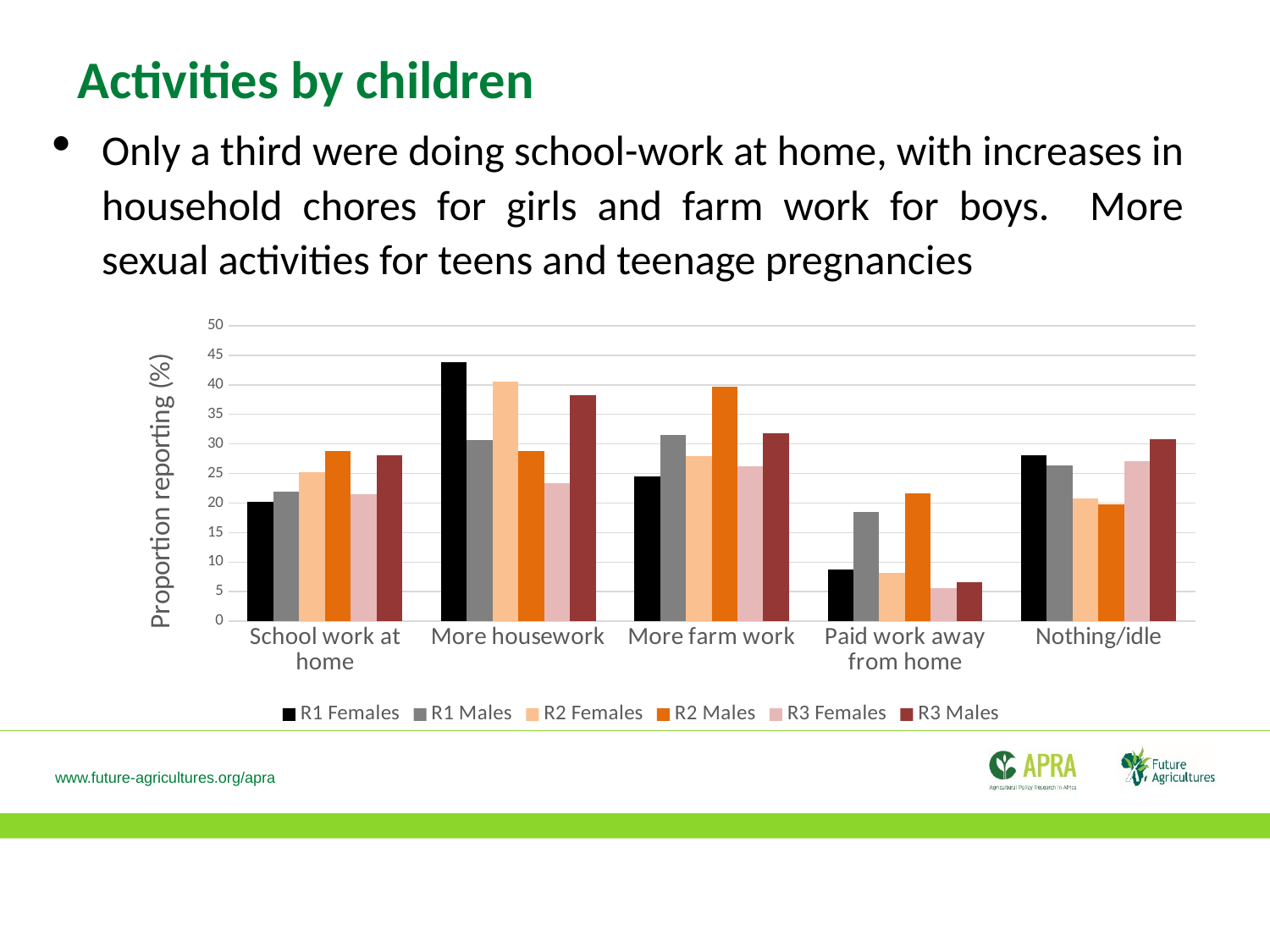
For More farm work, which is larger: the R2 Males value or the R1 Females value? R2 Males Is the R3 Females value for Paid work away from home greater or less than 10? less Is the R1 Females value for More housework greater or less than 40? greater What kind of chart is shown on the slide? bar chart For Paid work away from home, which is larger: the R1 Males value or the R2 Females value? R1 Males What is the label of the vertical axis of the chart? Proportion reporting (%) For which activity is the R3 Females value lowest? Paid work away from home For which activity is the R1 Females value highest? More housework Is the R2 Males value for More farm work greater or less than 35? greater How many series does the chart's legend list? 6 Which series has the highest value for Paid work away from home? R2 Males How many activity categories are shown on the x axis of the chart? 5